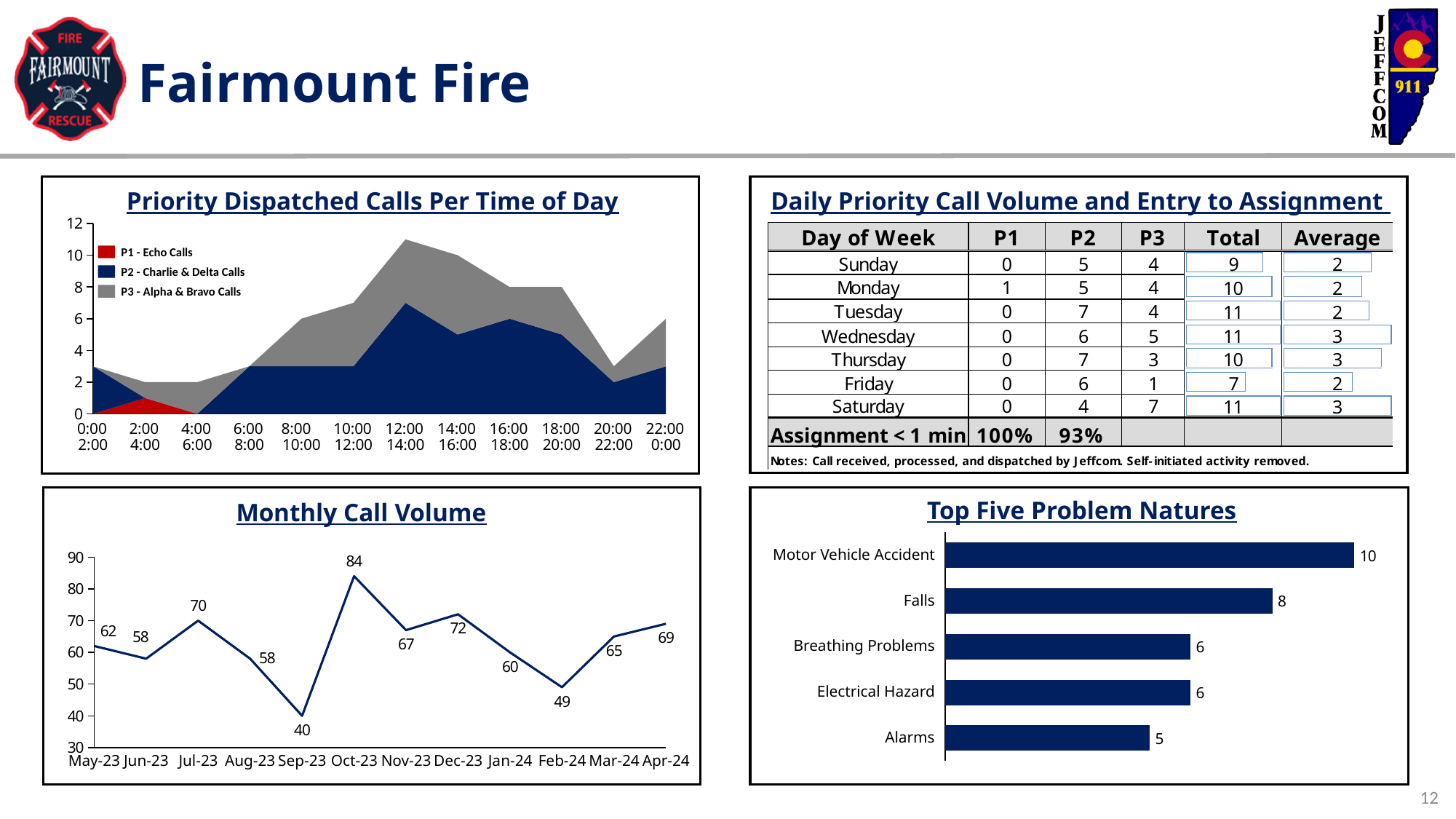
On the Monthly Call Volume chart, how many months are plotted? 12 What kind of chart is the Top Five Problem Natures chart? bar chart On the Top Five Problem Natures chart, what is the difference between Motor Vehicle Accident and Alarms? 5 On the Priority Dispatched Calls Per Time of Day chart, how many series does the legend list? 3 On the Top Five Problem Natures chart, what is the value for Falls? 8 On the Monthly Call Volume chart, do values rise or fall from Dec-23 to Feb-24? fall On the Priority Dispatched Calls Per Time of Day chart, is the total stacked value at 12:00-14:00 greater or less than 10? greater On the Monthly Call Volume chart, what is the value for Oct-23? 84 On the Monthly Call Volume chart, which month has the highest call volume? Oct-23 On the Monthly Call Volume chart, which month has the lowest call volume? Sep-23 On the Monthly Call Volume chart, what is the difference between the Oct-23 and Sep-23 values? 44 On the Top Five Problem Natures chart, which problem nature has the highest value? Motor Vehicle Accident